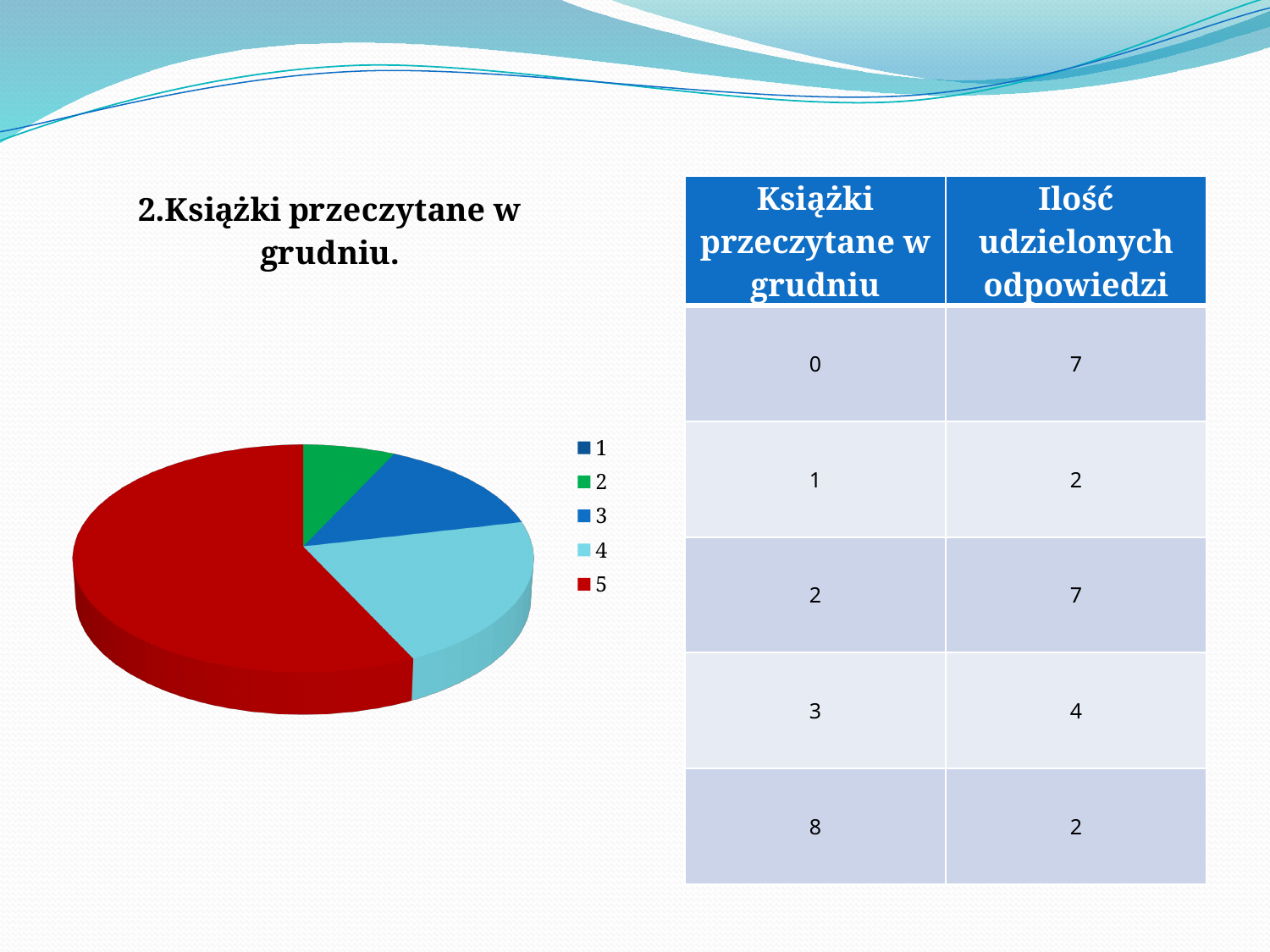
How many entries does the legend of the pie chart list? 5 Which legend category has the largest slice in the pie chart? 5 What colour is the slice for legend entry 5 in the pie chart? red In the pie chart, which slice is larger, the one for 3 or the one for 2? 3 What kind of chart is shown on the slide? pie chart In the pie chart, which slice is larger, the one for 4 or the one for 2? 4 What is the title of the chart on the slide? 2.Książki przeczytane w grudniu. In the pie chart, which slice is larger, the one for 5 or the one for 4? 5